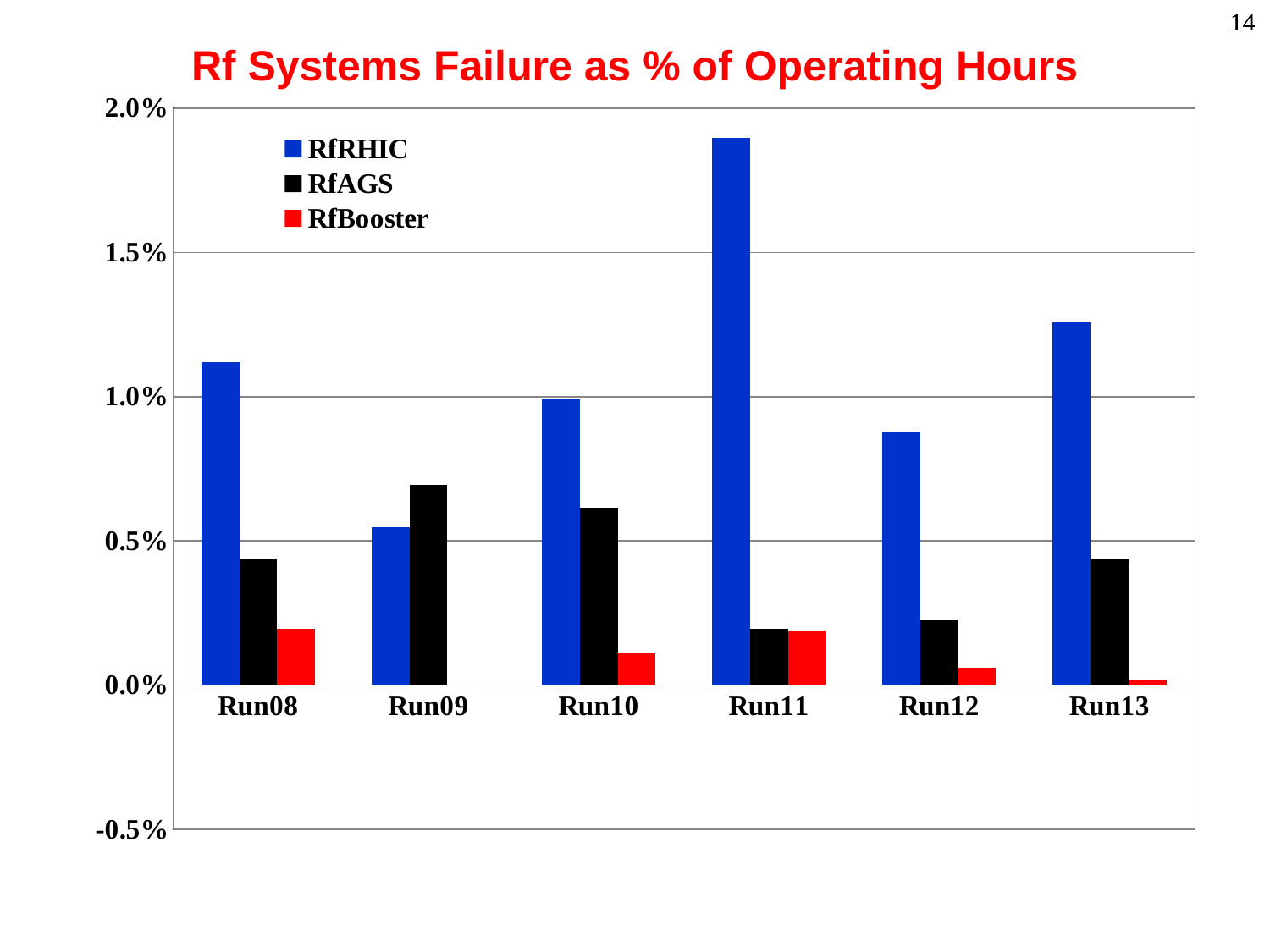
In Run09, which is larger, the RfRHIC value or the RfAGS value? RfAGS What is the title of the chart? Rf Systems Failure as % of Operating Hours How many runs are shown along the x axis? 6 Is the RfAGS value for Run10 greater or less than 0.5%? greater Is the RfRHIC value for Run11 greater or less than 1.5%? greater Is the RfRHIC value for Run08 greater or less than 1.0%? greater Which is larger, the RfRHIC value for Run13 or the RfRHIC value for Run08? Run13 In which run is the RfAGS failure percentage highest? Run09 How many series does the legend list? 3 In which run is the RfRHIC failure percentage lowest? Run09 What kind of chart is shown on the slide? bar chart In which run is the RfRHIC failure percentage highest? Run11